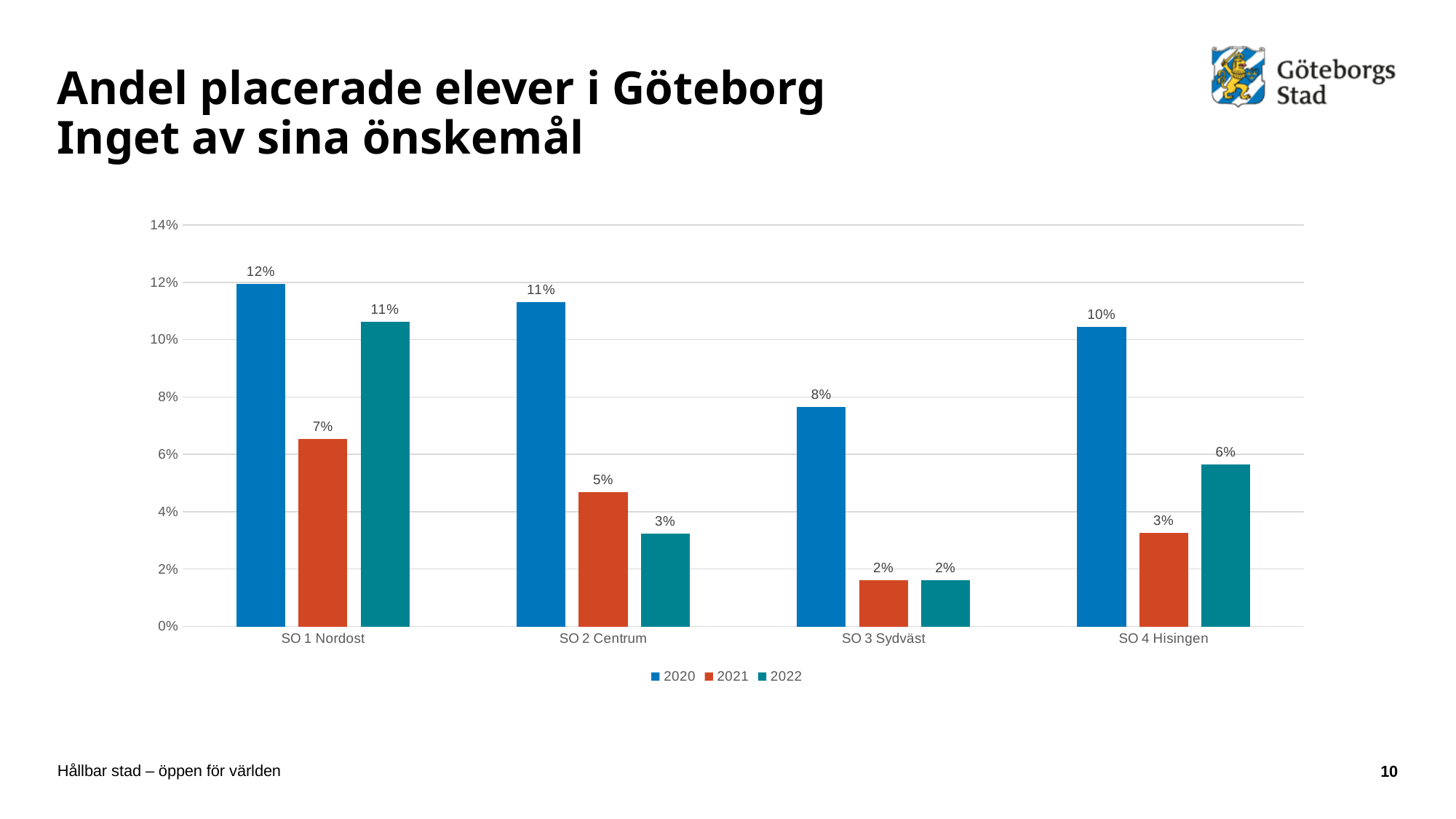
Is the 2021 value for SO 2 Centrum greater or less than 4%? greater Which category has the lowest value for 2020? SO 3 Sydväst For SO 2 Centrum, do the values rise or fall from 2020 to 2022? fall What is the value for SO 1 Nordost in 2020? 12% What type of chart is shown on the slide? bar chart Which is larger: the 2021 value for SO 1 Nordost or the 2020 value for SO 3 Sydväst? the 2020 value for SO 3 Sydväst What is the value for SO 2 Centrum in 2022? 3% Which category has the highest value for 2022? SO 1 Nordost What is the value for SO 4 Hisingen in 2021? 3% How many series does the legend list? 3 How many categories are shown on the x axis? 4 What is the difference between the 2020 and 2021 values for SO 1 Nordost? 5%